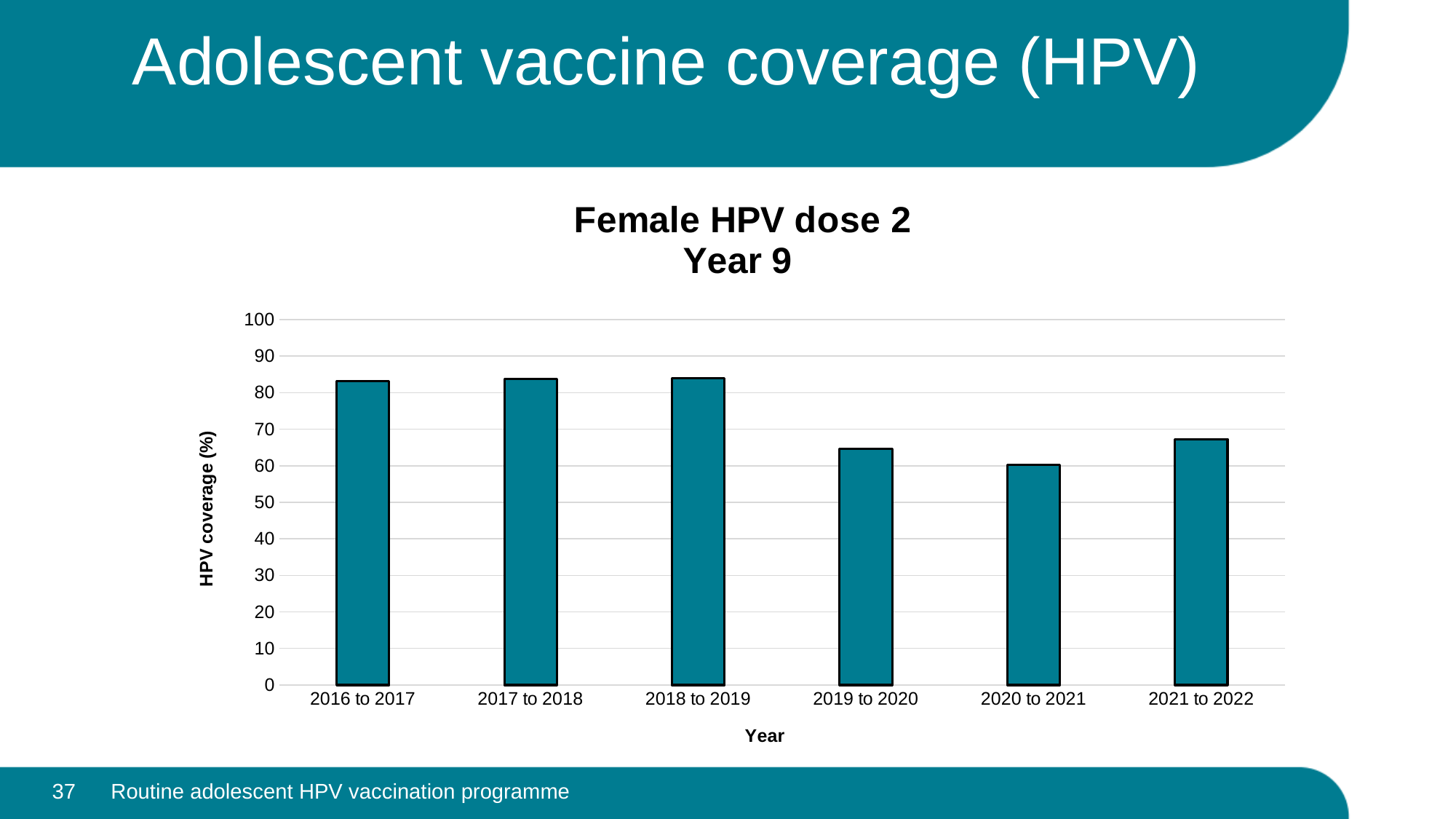
Which is larger, the value for 2020 to 2021 or the value for 2021 to 2022? 2021 to 2022 What kind of chart is shown on the slide? Bar chart Which is larger, the value for 2016 to 2017 or the value for 2019 to 2020? 2016 to 2017 Is the value for 2016 to 2017 greater or less than 80? greater Is the value for 2021 to 2022 greater or less than 70? less Is the value for 2020 to 2021 greater or less than 70? less Which year has the lowest HPV coverage? 2020 to 2021 How many year categories are plotted on the chart? 6 What is the title of the chart? Female HPV dose 2 Year 9 Does HPV coverage rise or fall from 2018 to 2019 through 2020 to 2021? fall